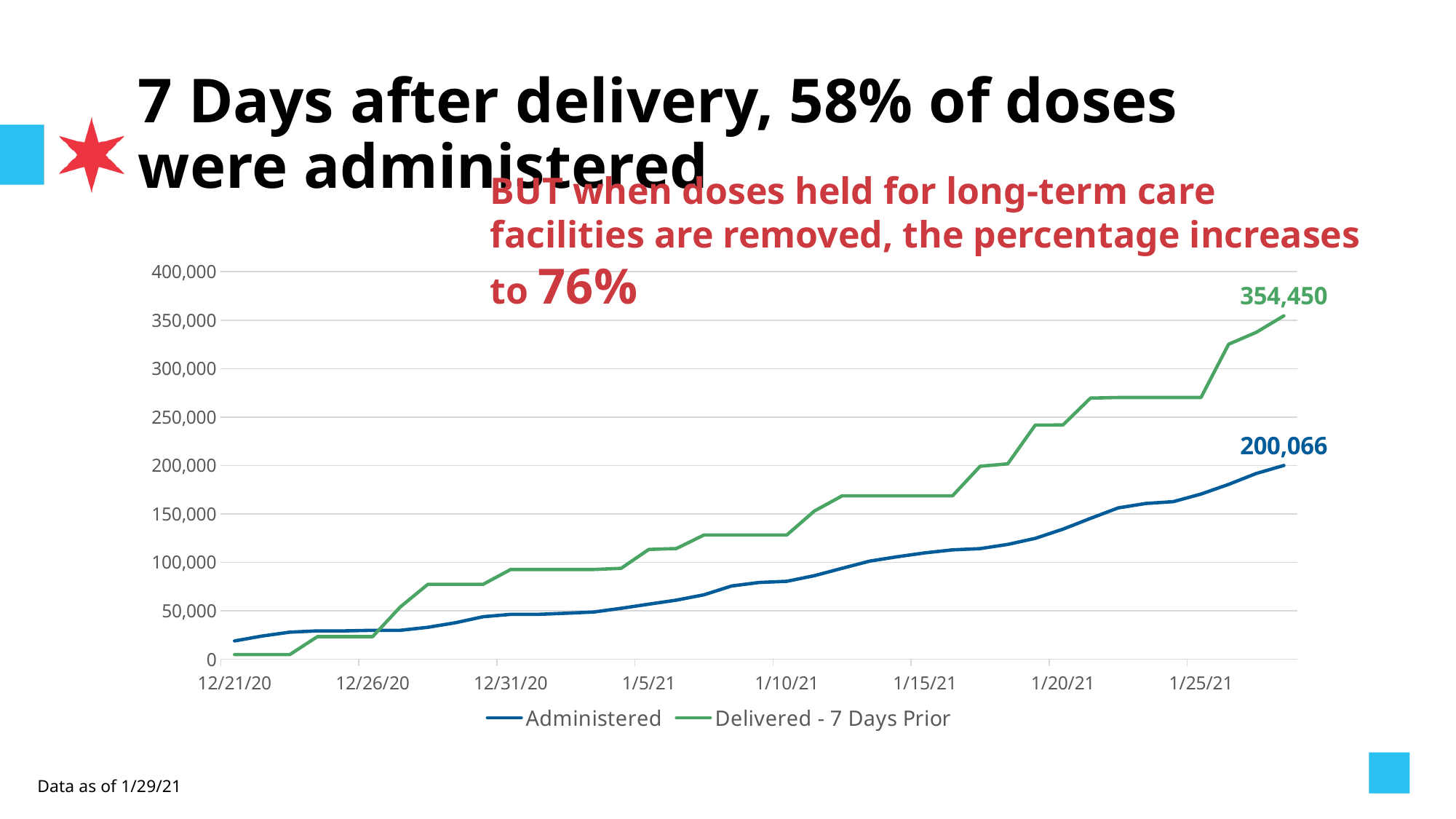
How many series does the legend list? 2 What is the first date shown on the x axis? 12/21/20 What is the final labelled value of the Delivered - 7 Days Prior series? 354,450 Which series ends higher at the right end of the chart, Administered or Delivered - 7 Days Prior? Delivered - 7 Days Prior Is the value of the Delivered - 7 Days Prior series on 1/15/21 greater or less than 150,000? greater What is the final labelled value of the Administered series? 200,066 What kind of chart is shown on the slide? Line chart Do the values of the Administered series rise or fall from 12/21/20 to the end of the chart? Rise Is the value of the Delivered - 7 Days Prior series on 12/21/20 greater or less than 50,000? less What colour is the line for the Delivered - 7 Days Prior series? Green What is the difference between the final labelled values of Delivered - 7 Days Prior and Administered? 154,384 Is the value of the Administered series on 1/10/21 greater or less than 100,000? less